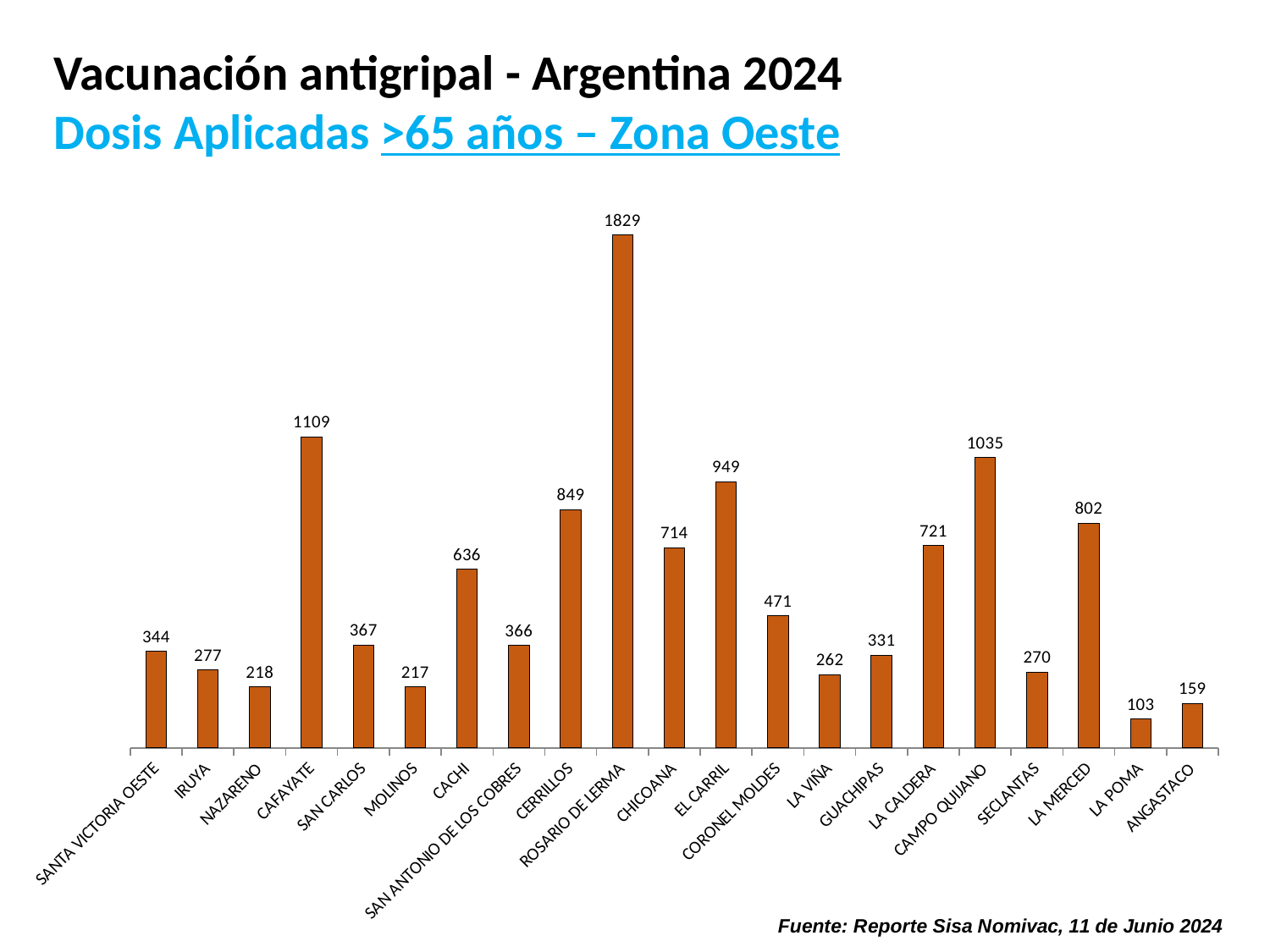
How many localities are shown on the x axis of the chart? 21 What is the difference between the values for Rosario de Lerma and Campo Quijano? 794 What kind of chart is shown on the slide? Bar chart Which locality has the lowest number of doses applied? La Poma How many doses were applied in Rosario de Lerma? 1829 What is the value shown for La Merced? 802 What source is cited below the chart? Reporte Sisa Nomivac, 11 de Junio 2024 Which locality has the highest number of doses applied? Rosario de Lerma Which has a larger value, Cachi or Chicoana? Chicoana What is the value shown for Cafayate? 1109 What is the difference between the values for El Carril and Cerrillos? 100 Which has a larger value, La Caldera or Coronel Moldes? La Caldera